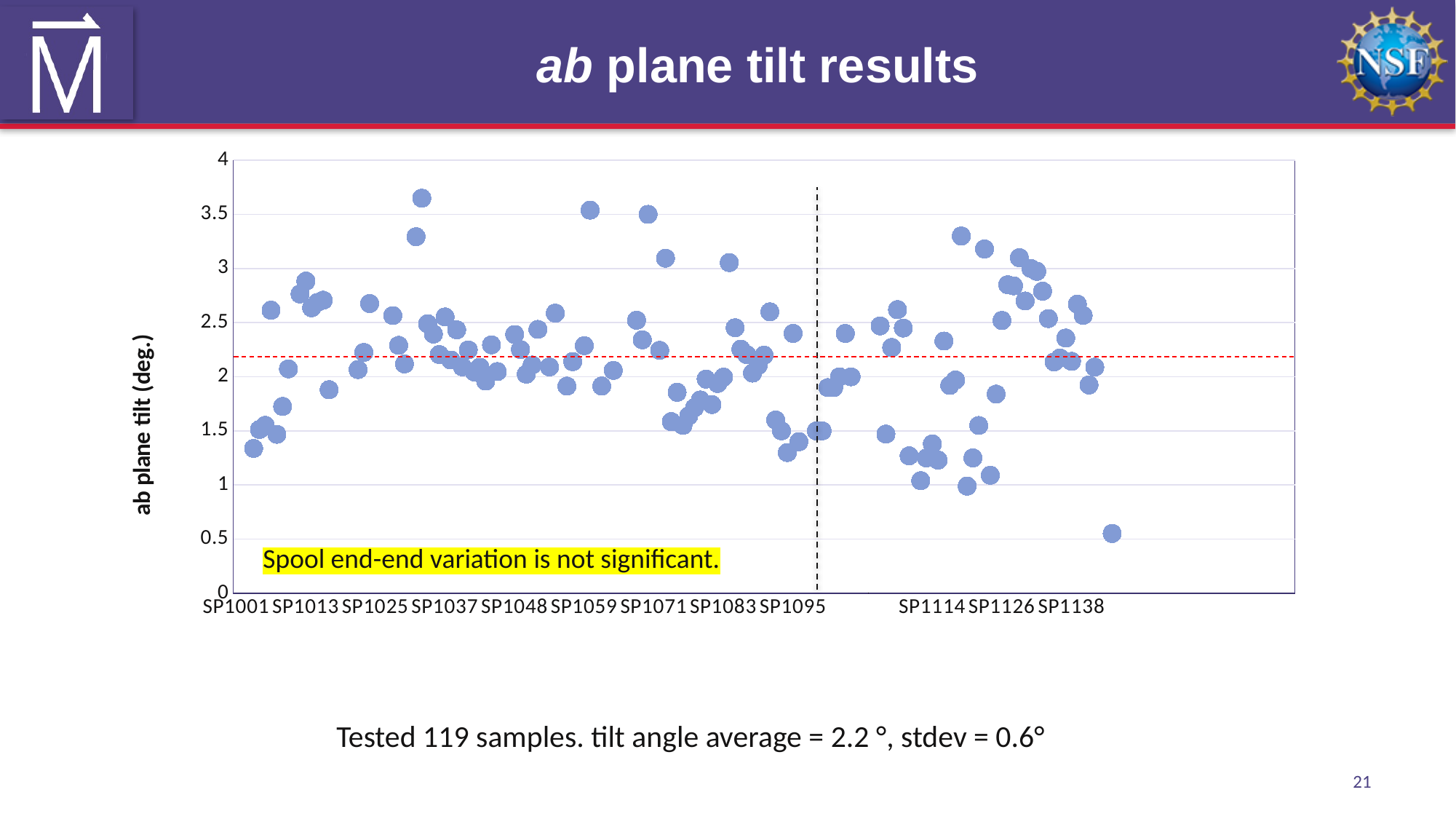
What is the last sample label on the x axis of the chart? SP1138 What is the maximum value shown on the y axis of the chart? 4 What kind of chart is shown on the slide? scatter chart What is the label of the y axis of the chart? ab plane tilt (deg.) What is the average tilt angle stated on the slide? 2.2 ° What is the first sample label on the x axis of the chart? SP1001 What is the title of the slide containing the chart? ab plane tilt results Is the lowest plotted ab plane tilt value greater or less than 1? less What is the standard deviation of the tilt angle stated on the slide? 0.6° Is the highest plotted ab plane tilt value greater or less than 3.5? greater How many samples were tested according to the slide? 119 How many sample labels are printed along the x axis of the chart? 12